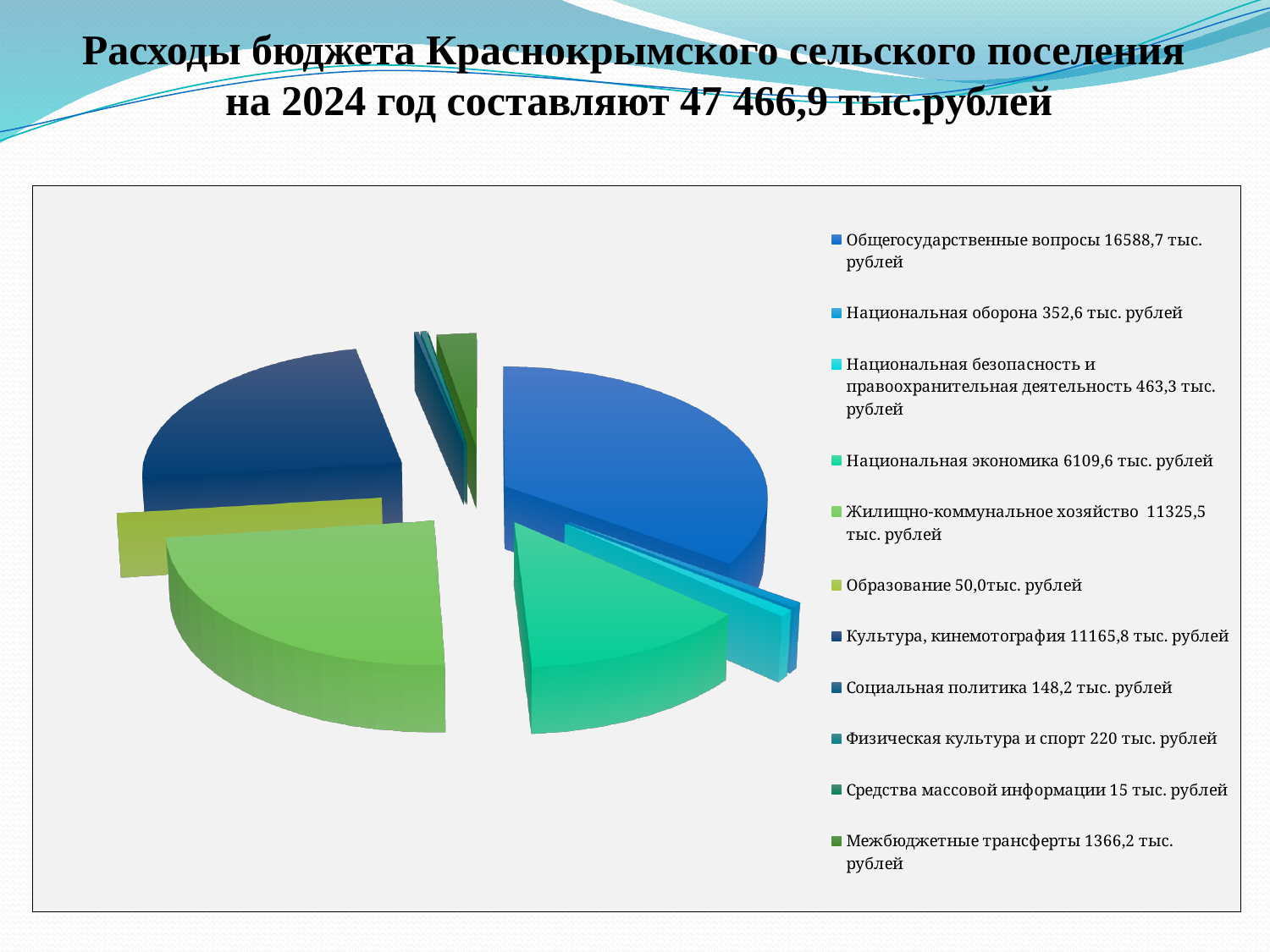
What is the value for Общегосударственные вопросы? 16588,7 тыс. рублей What is the value for Средства массовой информации? 15 тыс. рублей What is the difference between Общегосударственные вопросы and Жилищно-коммунальное хозяйство? 5263,2 тыс. рублей What is the difference between Национальная экономика and Межбюджетные трансферты? 4743,4 тыс. рублей Which category has the highest value? Общегосударственные вопросы What is the value for Национальная экономика? 6109,6 тыс. рублей What type of chart is shown on the slide? Pie chart Which category has the lowest value? Средства массовой информации How many categories does the legend of the pie chart list? 11 According to the slide title, what is the total budget expenditure for 2024? 47 466,9 тыс.рублей What is the value for Жилищно-коммунальное хозяйство? 11325,5 тыс. рублей Which is larger: Жилищно-коммунальное хозяйство or Культура, кинемотография? Жилищно-коммунальное хозяйство